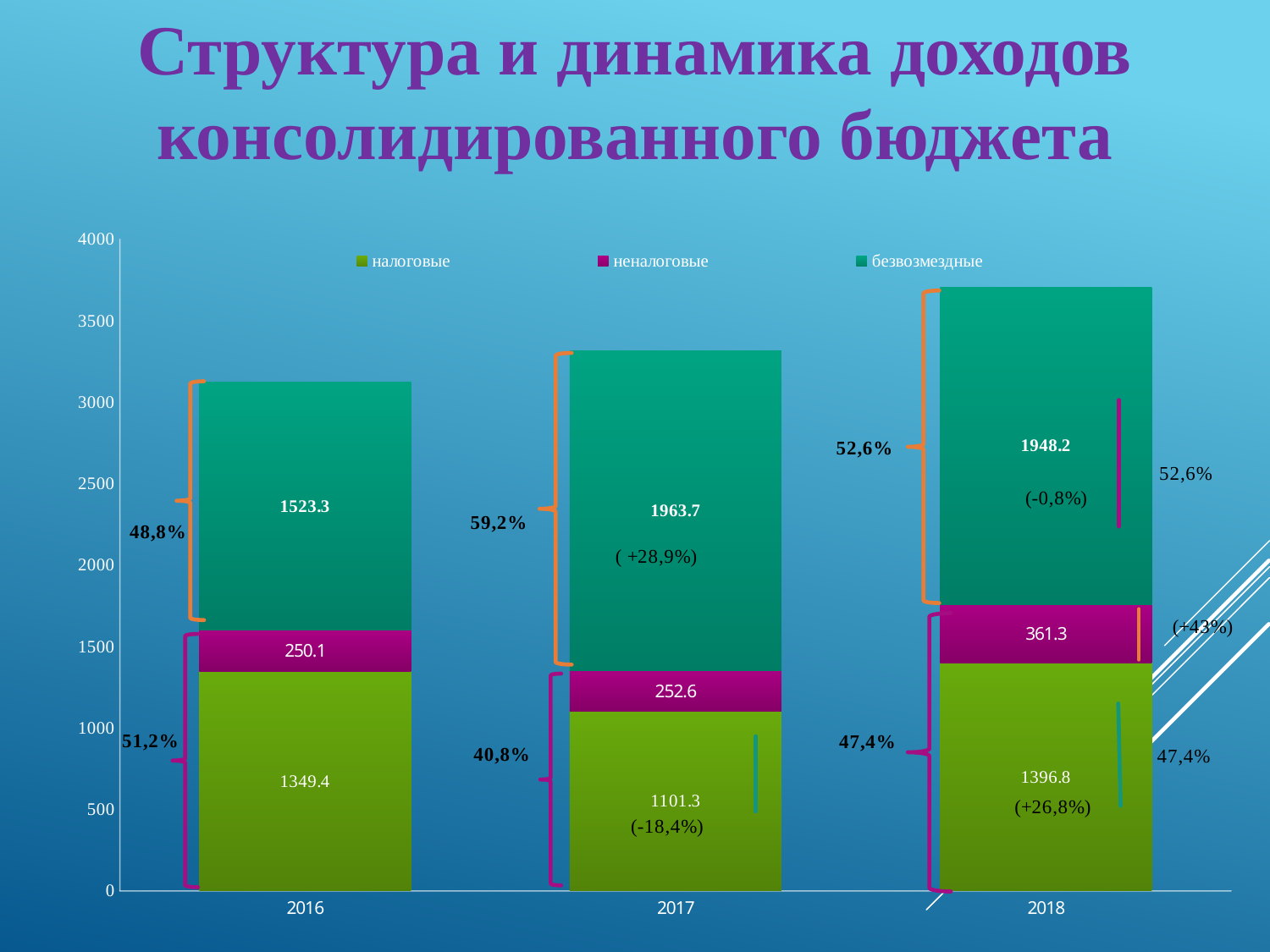
What is the value of налоговые for 2016? 1349.4 What is the difference between the безвозмездные values for 2017 and 2016? 440.4 In which year is the value of неналоговые the highest? 2018 What type of chart is shown on the slide? stacked bar chart Which is larger: налоговые in 2016 or налоговые in 2017? налоговые in 2016 How many years are shown on the x axis? 3 In which year is the value of безвозмездные the lowest? 2016 How many series does the legend list? 3 What is the value of неналоговые for 2018? 361.3 What is the value of безвозмездные for 2017? 1963.7 What is the total of the stacked bar for 2018? 3706.3 Which series is shown in green in the legend? налоговые